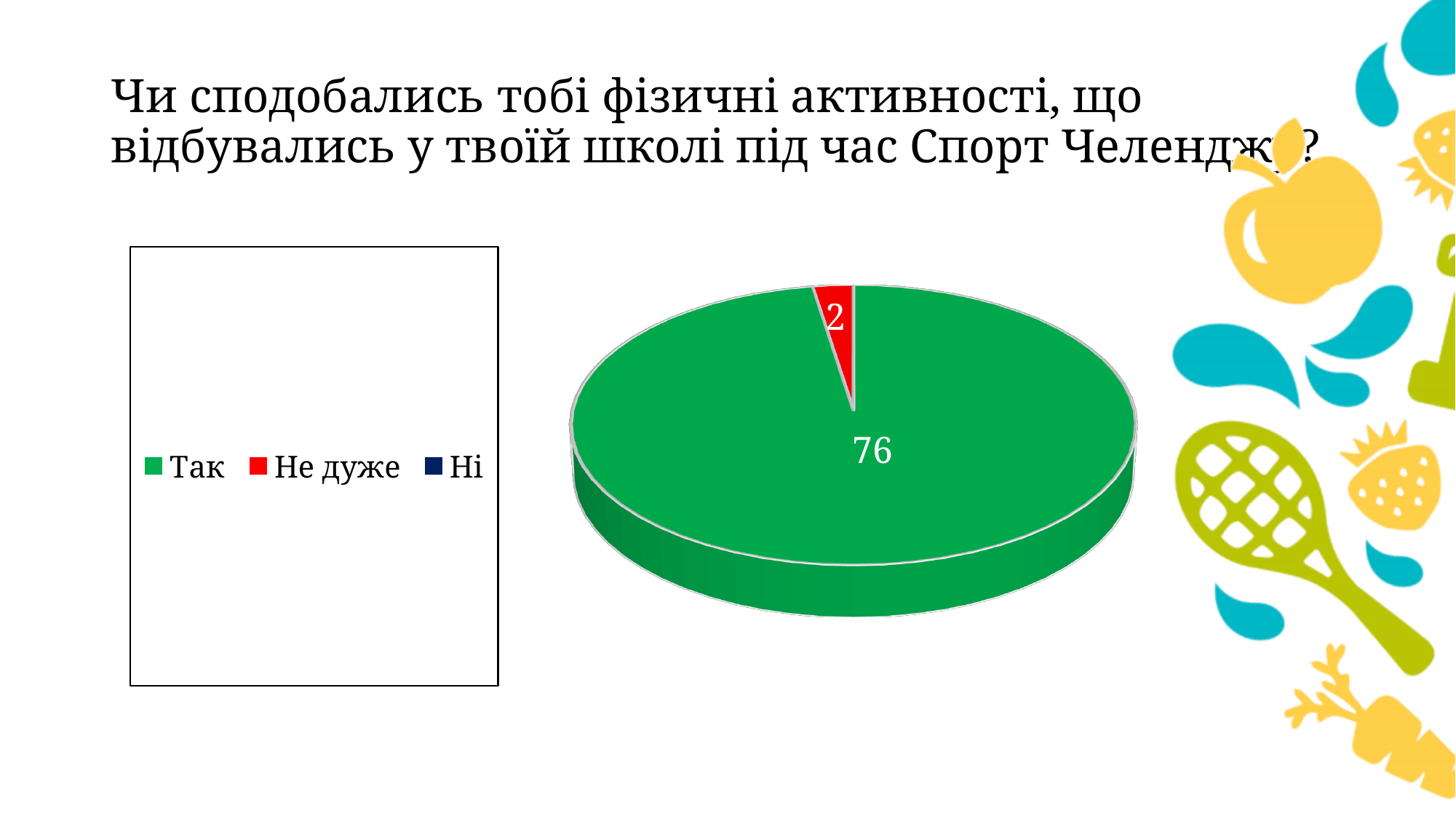
How many entries does the legend list? 3 Which is larger, the value for "Так" or the value for "Не дуже"? Так What colour is the slice for "Не дуже"? red What is the value for "Не дуже" in the pie chart? 2 Which category has the largest slice in the pie chart? Так What kind of chart is shown on the slide? pie chart What is the difference between the values for "Так" and "Не дуже"? 74 What colour is the slice for "Так"? green What is the value for "Так" in the pie chart? 76